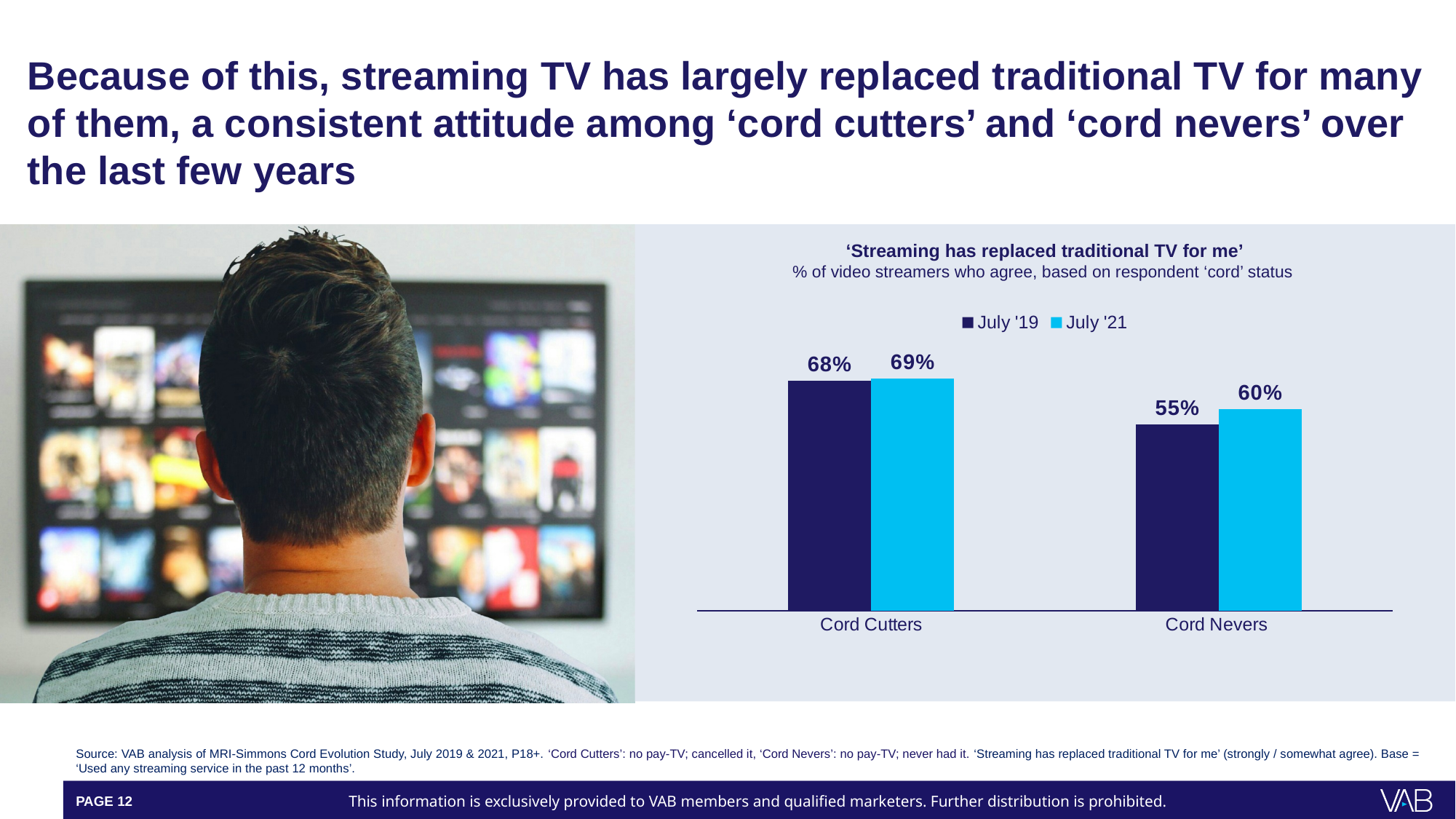
How many categories are shown on the x axis? 2 What is the difference between the July '21 and July '19 values for Cord Nevers? 5 percentage points Which category has the lowest value in July '19? Cord Nevers What percentage of Cord Cutters agreed in July '21? 69% What percentage of Cord Nevers agreed in July '19? 55% What is the difference between the Cord Cutters and Cord Nevers values in July '19? 13 percentage points Which category has the highest value in July '21? Cord Cutters What percentage of Cord Nevers agreed in July '21? 60% How many series does the legend list? 2 What kind of chart is shown on the slide? Bar chart Which is larger: the July '19 value for Cord Cutters or the July '21 value for Cord Nevers? July '19 value for Cord Cutters What percentage of Cord Cutters agreed in July '19? 68%